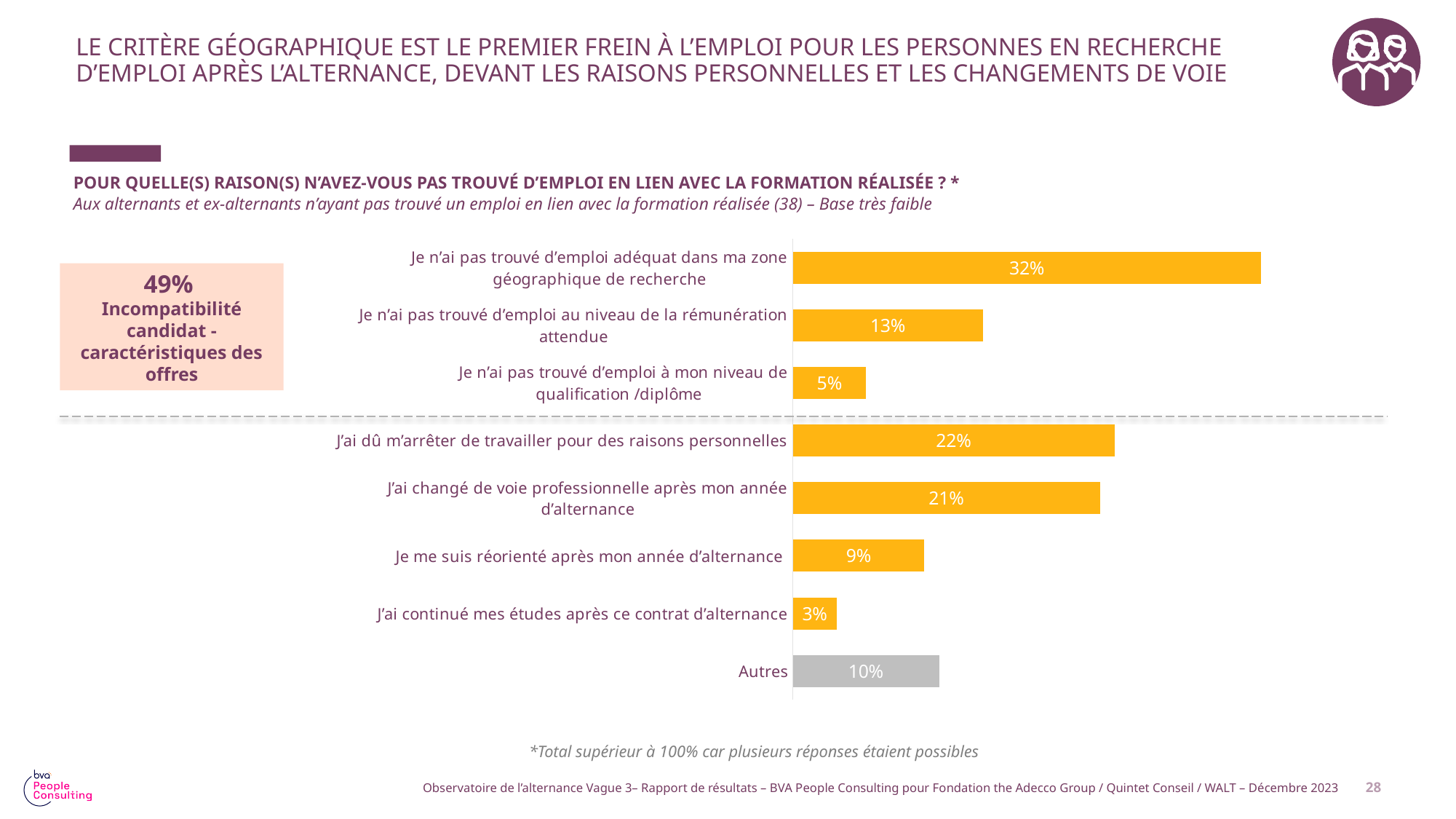
What is the value for "J'ai dû m'arrêter de travailler pour des raisons personnelles"? 22% What percentage of respondents said they did not find a job in their geographic search area ("Je n'ai pas trouvé d'emploi adéquat dans ma zone géographique de recherche")? 32% Which reason has the highest percentage? Je n'ai pas trouvé d'emploi adéquat dans ma zone géographique de recherche What is the difference between the value for "J'ai dû m'arrêter de travailler pour des raisons personnelles" and the value for "J'ai changé de voie professionnelle après mon année d'alternance"? 1% Which reason has the lowest percentage? J'ai continué mes études après ce contrat d'alternance What kind of chart is shown on the slide? Bar chart What is the value for "Autres"? 10% What is the combined percentage shown in the highlighted box for "Incompatibilité candidat - caractéristiques des offres"? 49% What is the value for "J'ai continué mes études après ce contrat d'alternance"? 3% Which bar is coloured grey rather than yellow? Autres How many categories (bars) are shown in the chart? 8 Which is larger: the value for "Je n'ai pas trouvé d'emploi au niveau de la rémunération attendue" or the value for "Je me suis réorienté après mon année d'alternance"? Je n'ai pas trouvé d'emploi au niveau de la rémunération attendue